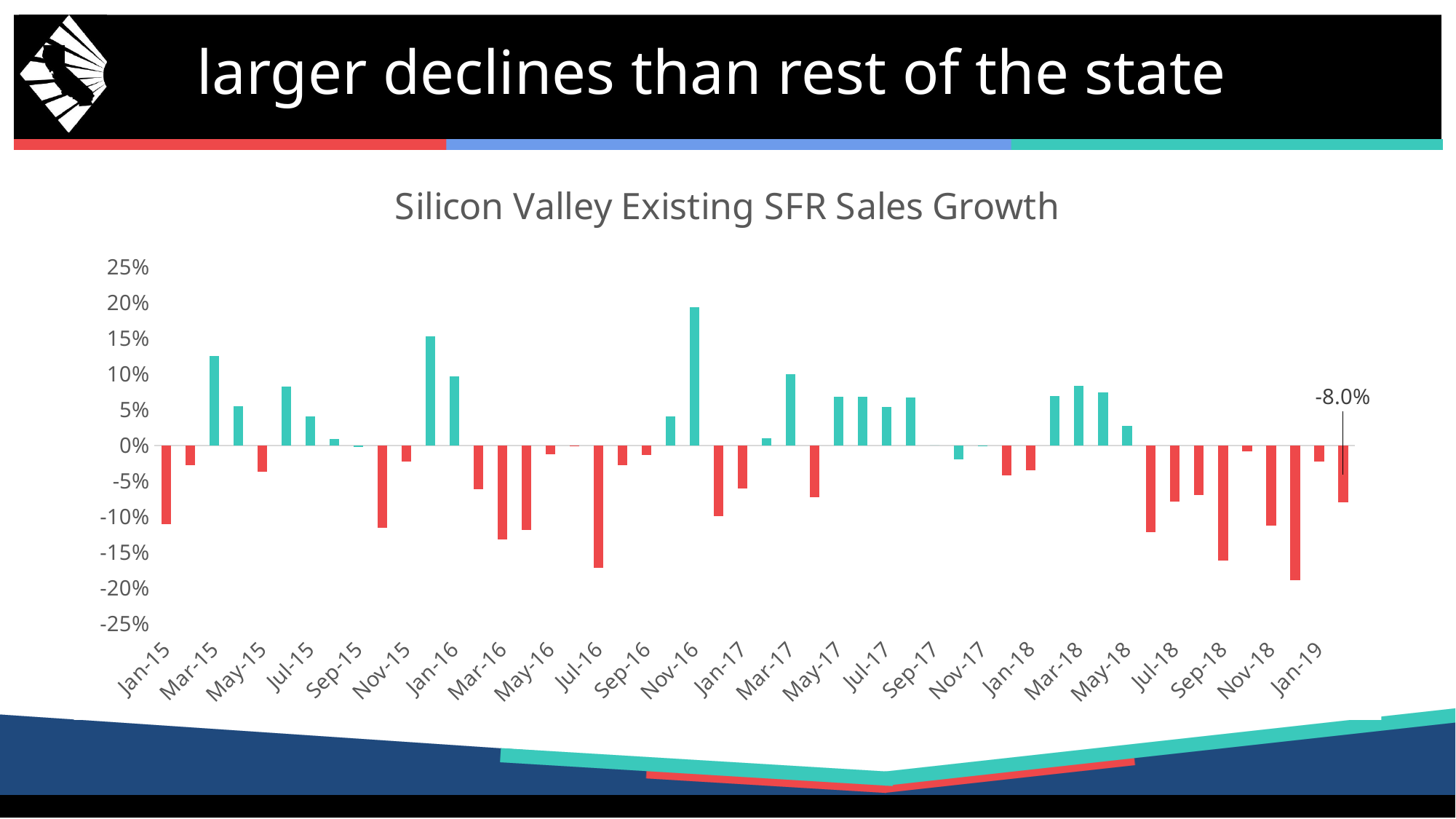
What value is printed as a data label on the last bar of the chart? -8.0% How many month labels are shown on the x axis? 25 What colour are the bars with negative values? red Is the value for Mar-15 greater or less than 10%? greater Is the value for Nov-16 greater or less than 15%? greater What type of chart is shown on the slide? bar chart Which is larger, the value for Nov-16 or the value for Mar-15? Nov-16 What is the title of the chart? Silicon Valley Existing SFR Sales Growth Which is larger, the value for Jan-15 or the value for Jul-16? Jan-15 Is the value for Jul-16 greater or less than -15%? less Which month has the highest sales growth in the chart? Nov-16